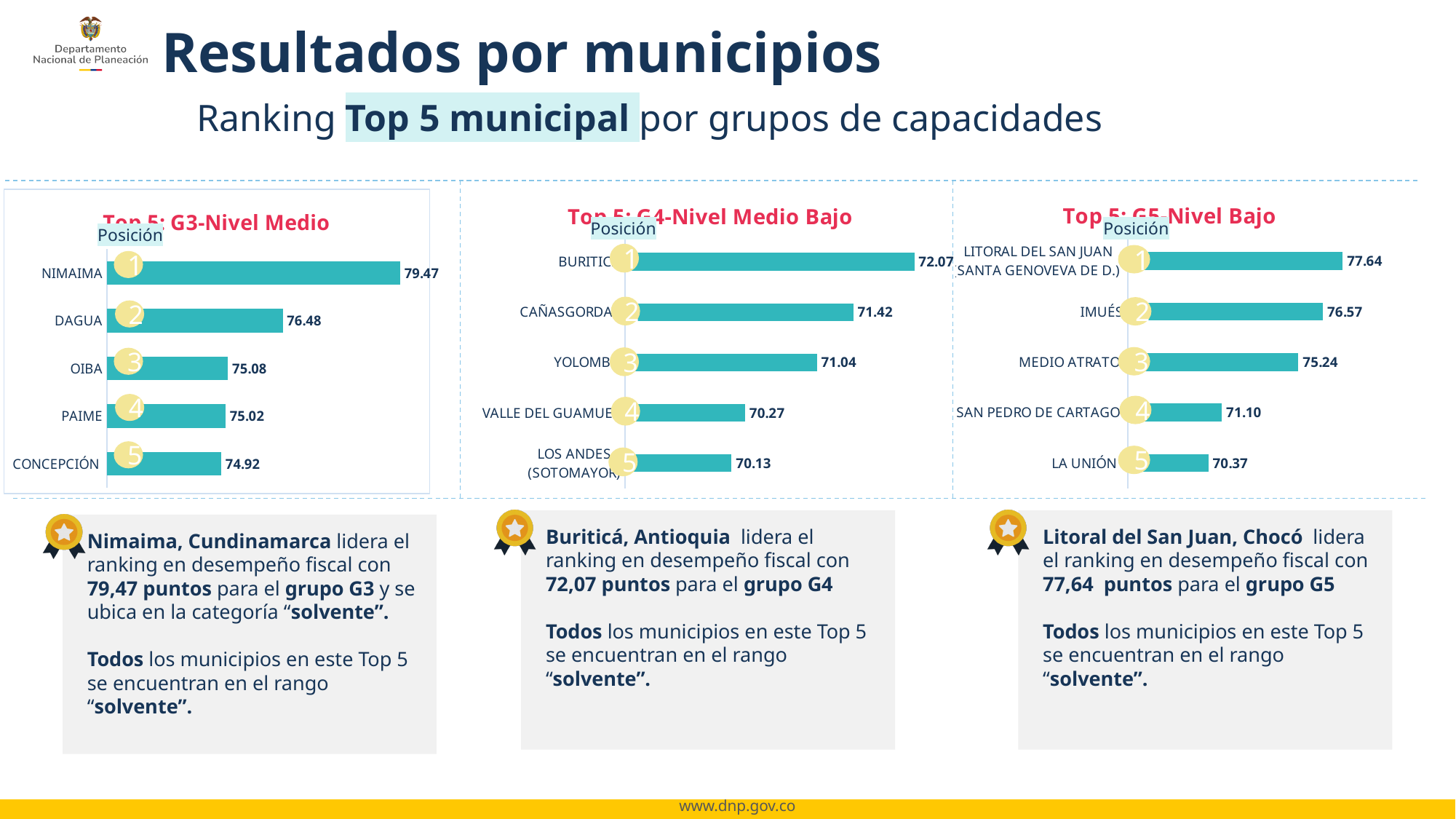
In the 'Top 5: G4-Nivel Medio Bajo' chart, what is the value for LOS ANDES (SOTOMAYOR)? 70.13 In the 'Top 5: G5-Nivel Bajo' chart, which municipality has the highest value? LITORAL DEL SAN JUAN (SANTA GENOVEVA DE D.) In the 'Top 5: G5-Nivel Bajo' chart, what is the value for MEDIO ATRATO? 75.24 In the 'Top 5: G4-Nivel Medio Bajo' chart, what is the value for CAÑASGORDA? 71.42 In the 'Top 5: G5-Nivel Bajo' chart, what is the difference between the values for LITORAL DEL SAN JUAN (SANTA GENOVEVA DE D.) and LA UNIÓN? 7.27 In the 'Top 5: G3-Nivel Medio' chart, what is the value for OIBA? 75.08 In the 'Top 5: G3-Nivel Medio' chart, what is the value for NIMAIMA? 79.47 What kind of chart is the 'Top 5: G3-Nivel Medio' chart? Bar chart In the 'Top 5: G4-Nivel Medio Bajo' chart, how many municipalities are shown? 5 In the 'Top 5: G5-Nivel Bajo' chart, which has a larger value, IMUÉS or SAN PEDRO DE CARTAGO? IMUÉS In the 'Top 5: G3-Nivel Medio' chart, what is the difference between the values for NIMAIMA and DAGUA? 2.99 In the 'Top 5: G3-Nivel Medio' chart, which municipality has the lowest value? CONCEPCIÓN